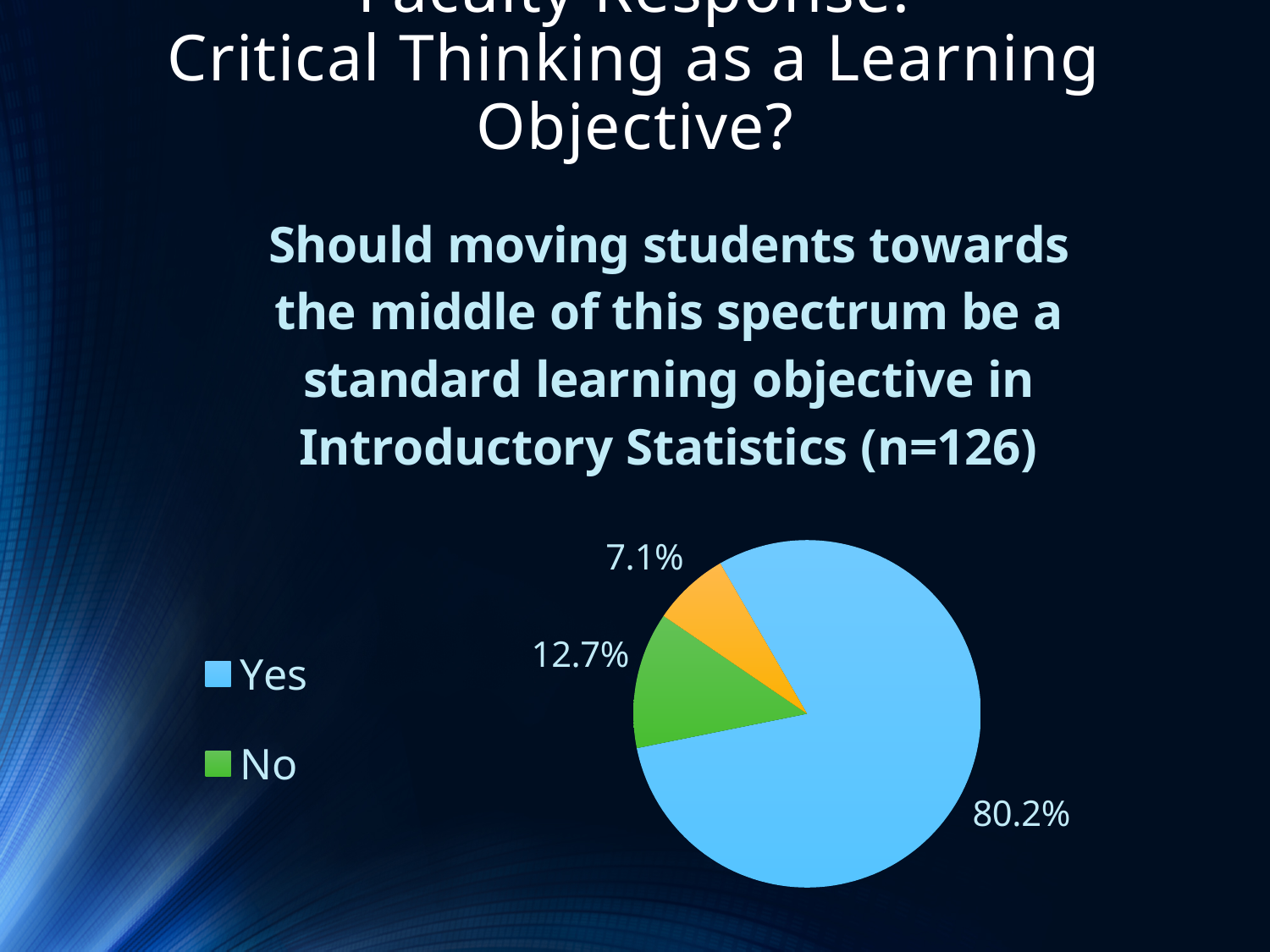
How many slices does the pie chart have? 3 What share of the pie does the No slice represent? 12.7% What kind of chart is shown on the slide? pie chart What colour is the Yes slice in the pie chart? blue What share of the pie does the Yes slice represent? 80.2% What is the difference in percentage points between the No slice and the orange 7.1% slice? 5.6 What sample size (n) is stated in the chart title? 126 What is the difference in percentage points between the Yes slice and the No slice? 67.5 How many entries does the legend list? 2 Which is larger, the Yes slice or the No slice? Yes Which slice of the pie is the largest? Yes What percentage is shown for the orange slice of the pie? 7.1%